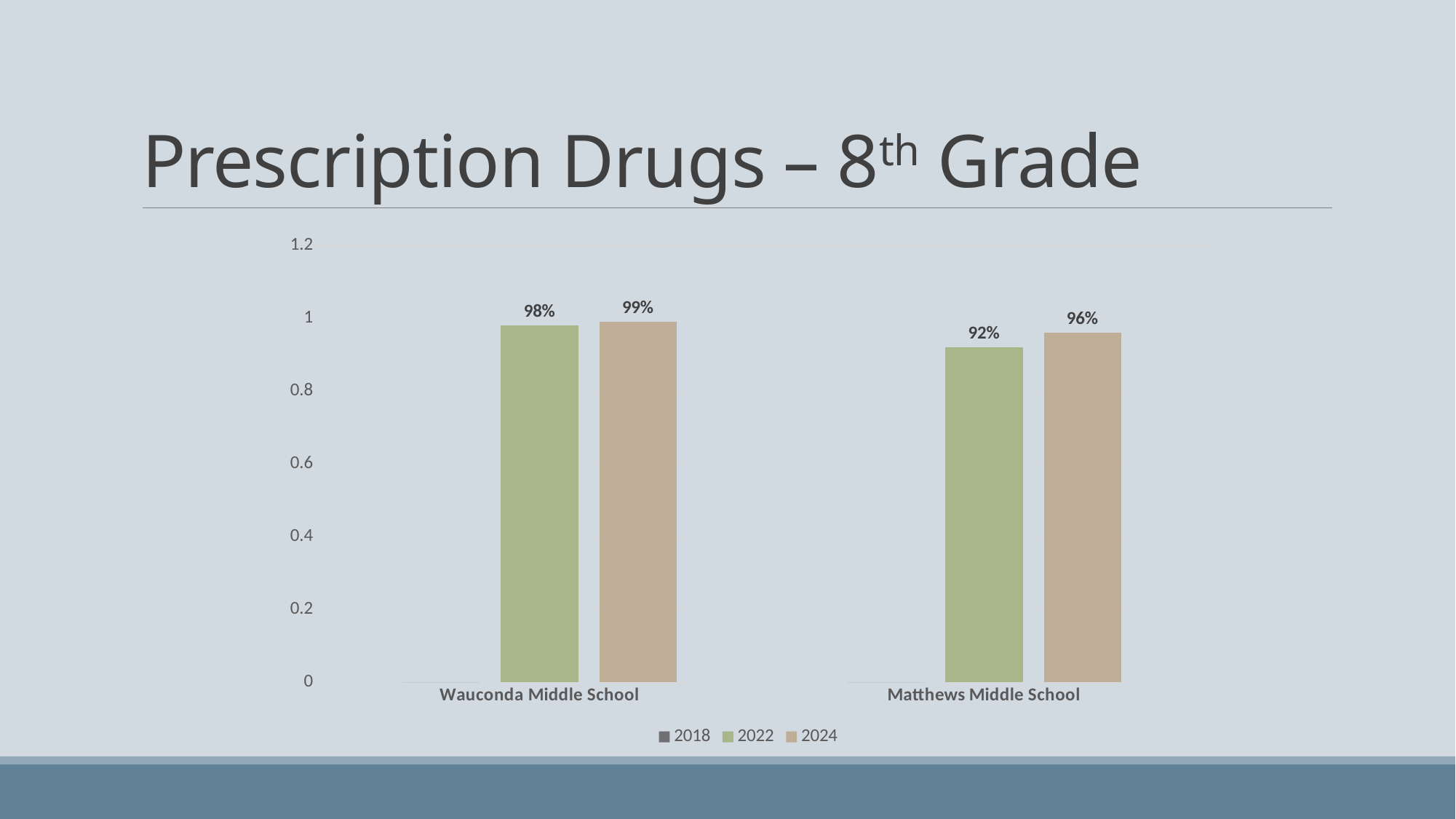
Which school has the lowest 2022 value? Matthews Middle School What kind of chart is shown on the slide? Bar chart How many schools are shown on the x axis? 2 What is the difference between the 2022 values for Wauconda Middle School and Matthews Middle School? 6% What is the 2022 value for Matthews Middle School? 92% How many series does the legend list? 3 What is the 2024 value for Matthews Middle School? 96% What is the difference between the 2024 and 2022 values for Matthews Middle School? 4% Which school has the highest 2024 value? Wauconda Middle School Which is larger: the 2022 value for Wauconda Middle School or the 2024 value for Matthews Middle School? Wauconda Middle School 2022 What is the 2024 value for Wauconda Middle School? 99% What is the 2022 value for Wauconda Middle School? 98%